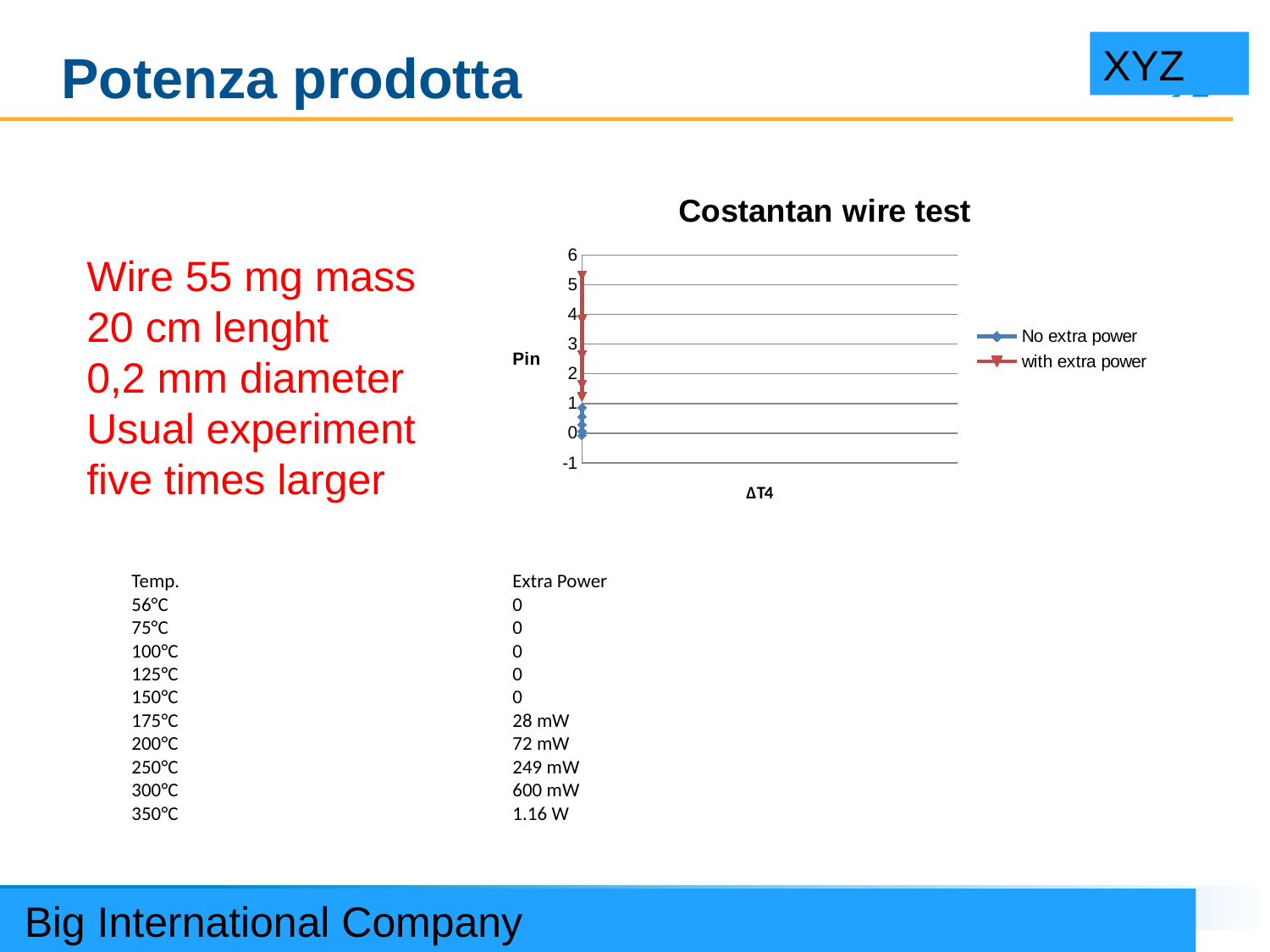
In the "Costantan wire test" chart, which series reaches higher Pin values, "No extra power" or "with extra power"? with extra power What is the label on the vertical axis of the "Costantan wire test" chart? Pin What is the title of the chart on the slide? Costantan wire test In the "Costantan wire test" chart, is the lowest "with extra power" point greater or less than 3? less In the "Costantan wire test" chart, are the "No extra power" points greater or less than 2? less What kind of chart is the "Costantan wire test" chart? line chart How many series does the legend of the "Costantan wire test" chart list? 2 In the "Costantan wire test" chart, is the highest "with extra power" point greater or less than 4? greater